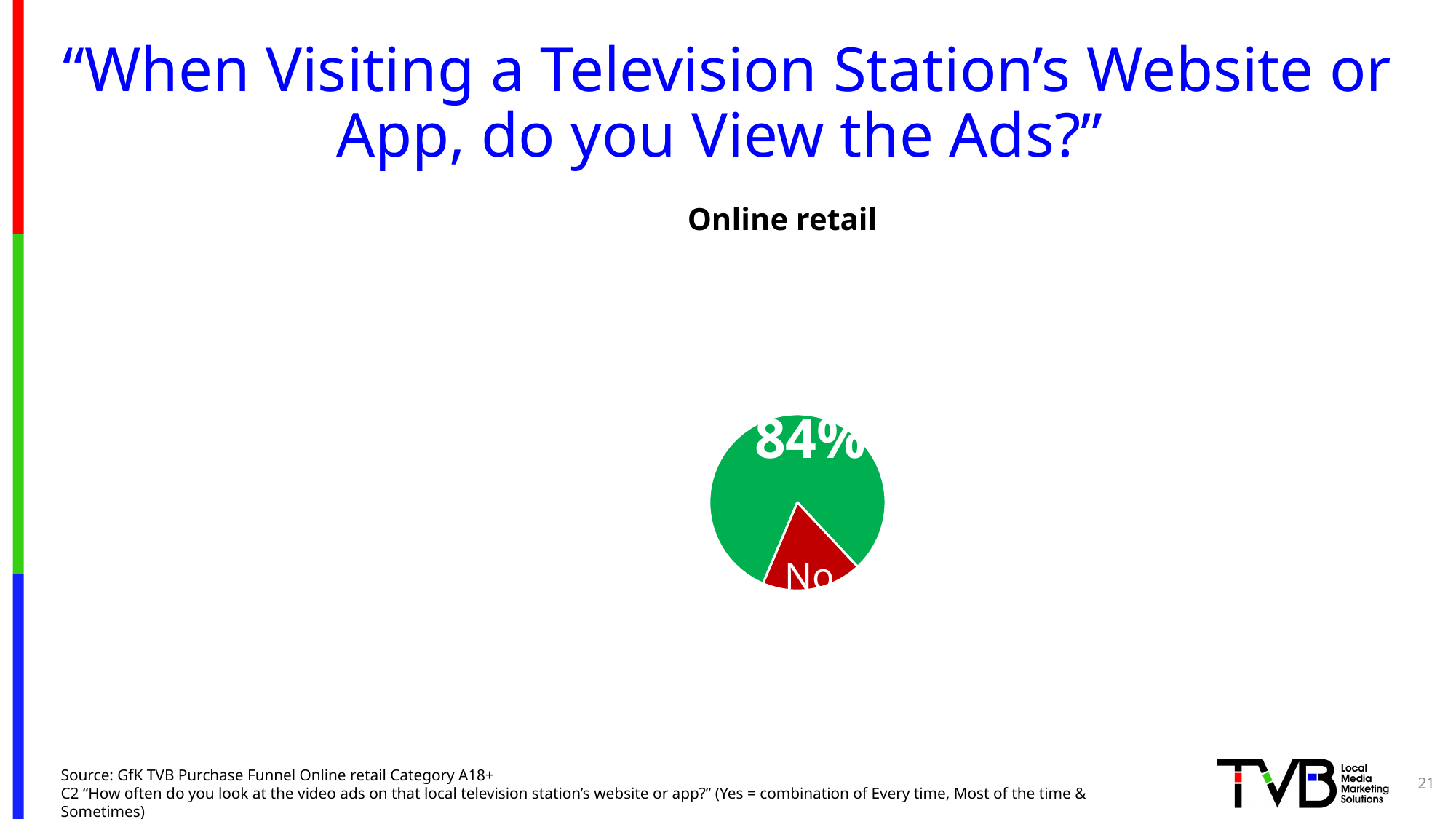
What percentage is printed on the green slice of the pie chart? 84% What kind of chart is shown on the slide? pie chart What share of the pie does the green slice represent? 84% What label is printed on the red slice of the pie chart? No What is the title of the chart? Online retail What colour is the slice labelled "No"? red Which slice of the pie chart is larger, the green one or the red one? the green one Which slice of the pie chart is the smallest? the red "No" slice Is the share of the "No" slice greater or less than 50%? less How many slices does the pie chart have? 2